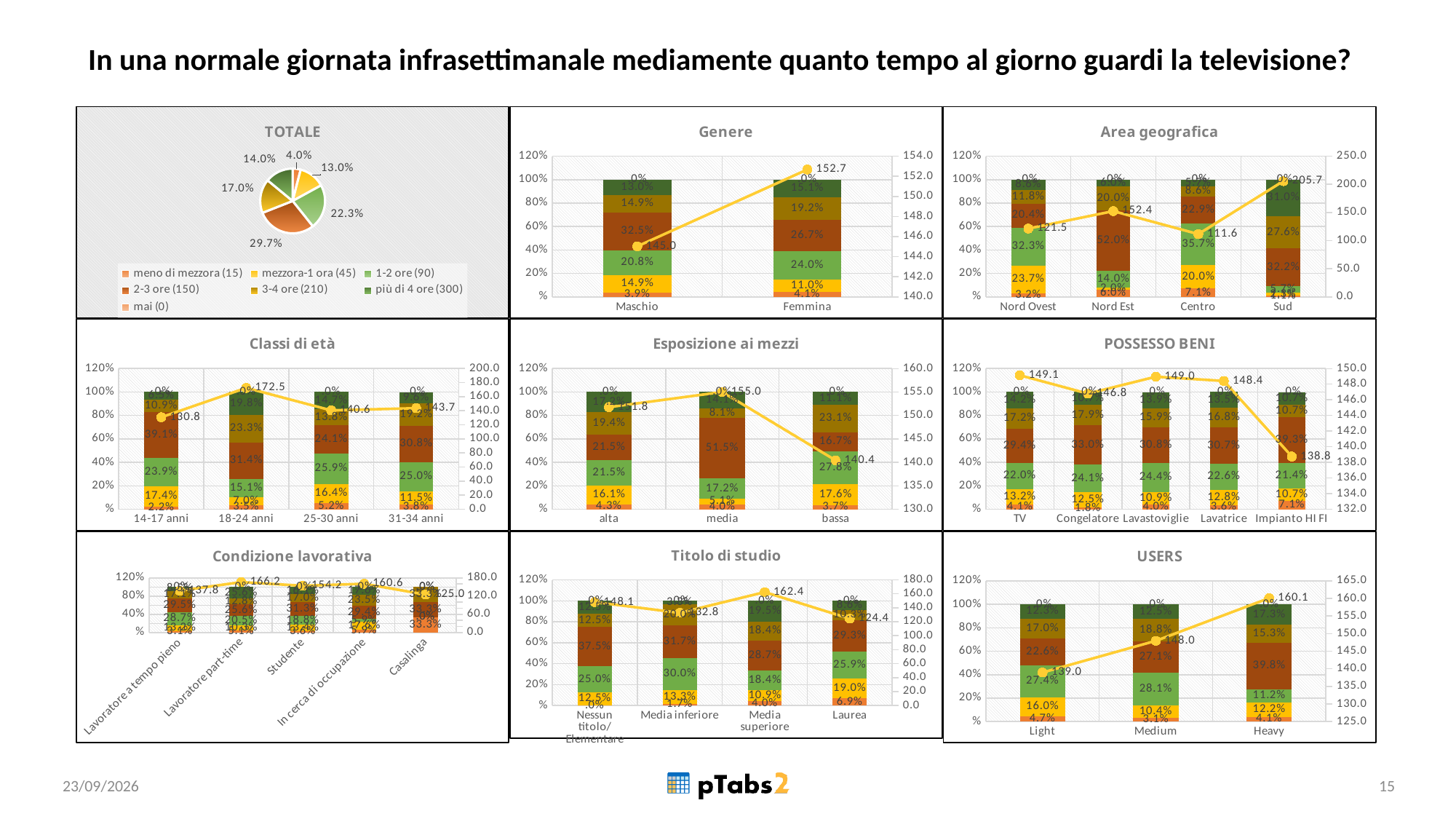
In the Titolo di studio chart, is the line value for Media superiore larger than that for Laurea? Yes How many entries does the legend of the TOTALE pie chart list? 7 In the Area geografica chart, what is the line value for Centro? 111.6 In the Esposizione ai mezzi chart, what is the line value for bassa? 140.4 In the Area geografica chart, which category has the highest line value? Sud In the Genere chart, what is the difference between the line values for Femmina and Maschio? 7.7 In the POSSESSO BENI chart, which category has the lowest line value? Impianto HI FI In the Genere chart, what is the line value for Femmina? 152.7 In the Classi di età chart, which age class has the highest line value? 18-24 anni How many categories are shown on the x axis of the Condizione lavorativa chart? 5 In the TOTALE pie chart, what share does the largest slice have? 29.7% In the USERS chart, do the line values rise or fall from Light to Heavy? rise